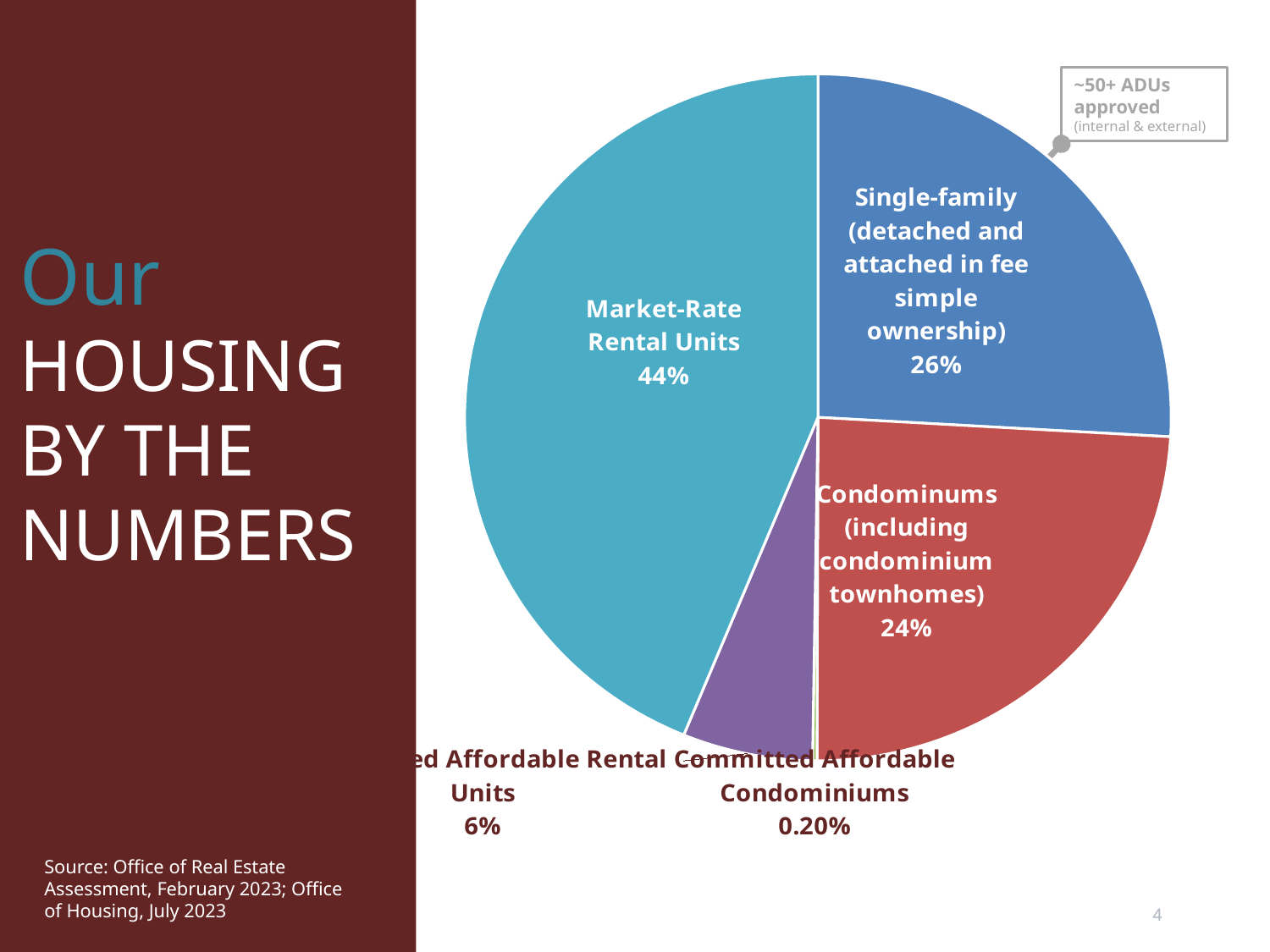
Which slice of the pie is the largest? Market-Rate Rental Units What colour is the Market-Rate Rental Units slice? teal Which is larger: the Single-family slice or the Condominiums (including condominium townhomes) slice? Single-family What percentage is shown for Single-family (detached and attached in fee simple ownership)? 26% What percentage is shown for the Affordable Rental Units slice? 6% How many slices does the pie chart have? 5 Which slice of the pie is the smallest? Committed Affordable Condominiums What share of the pie is Market-Rate Rental Units? 44% What percentage is shown for Condominiums (including condominium townhomes)? 24% What kind of chart is shown on the slide? pie chart What percentage is shown for Committed Affordable Condominiums? 0.20% What is the difference in percentage points between Market-Rate Rental Units and Single-family (detached and attached in fee simple ownership)? 18 percentage points